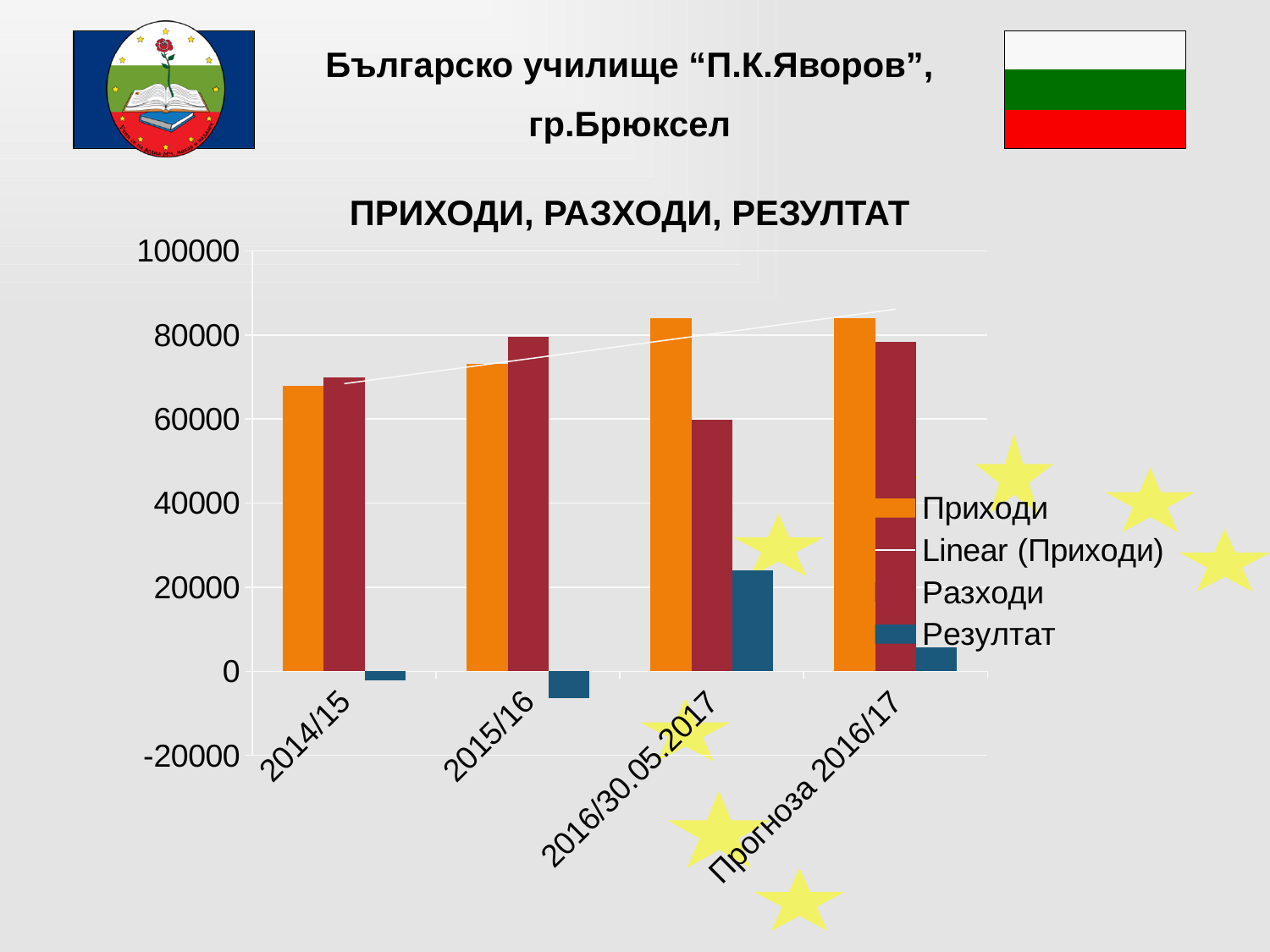
How many entries does the chart legend list? 4 Which category has the lowest value of Резултат? 2015/16 Is the value of Приходи for 2014/15 greater or less than 80000? less For 2015/16, which is larger: Приходи or Разходи? Разходи How many categories are shown on the x axis of the chart? 4 For 2016/30.05.2017, which is larger: Приходи or Разходи? Приходи Which category has the highest value of Резултат? 2016/30.05.2017 Is the value of Разходи for 2015/16 greater or less than 60000? greater What is the title of the chart? ПРИХОДИ, РАЗХОДИ, РЕЗУЛТАТ Is the value of Резултат for 2016/30.05.2017 greater or less than 20000? greater What type of chart is shown on the slide? bar chart Which category has the lowest value of Приходи? 2014/15